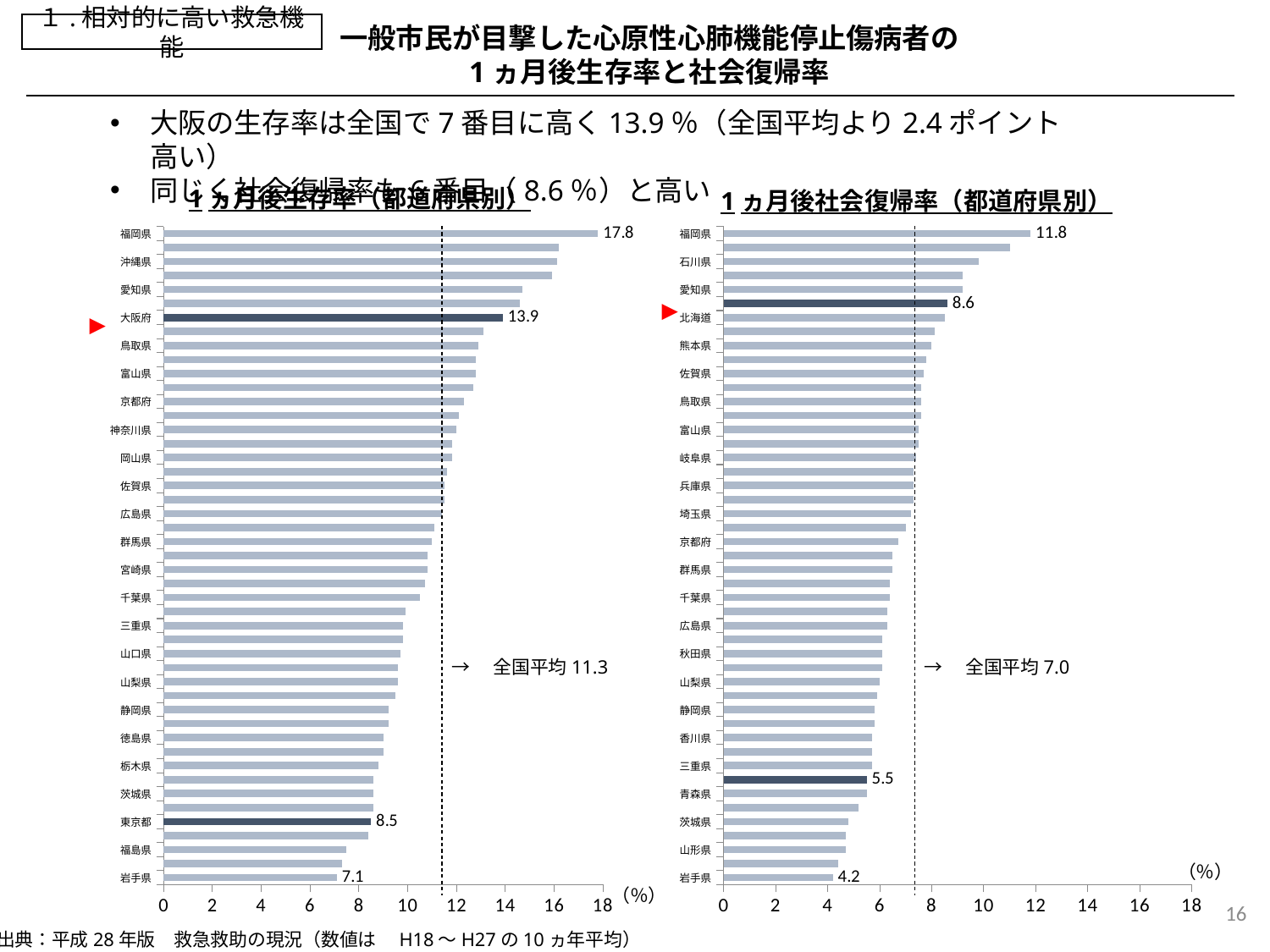
In the right chart (1ヵ月後社会復帰率), what is the value for 福岡県? 11.8 In the left chart (1ヵ月後生存率), which prefecture has the highest value? 福岡県 In the right chart (1ヵ月後社会復帰率), what national average (全国平均) is marked by the dashed line? 7.0 In the left chart (1ヵ月後生存率), what is the difference between the values for 福岡県 and 大阪府? 3.9 In the left chart (1ヵ月後生存率), what is the value for 大阪府? 13.9 In the left chart (1ヵ月後生存率), which is larger, the value for 大阪府 or the value for 東京都? 大阪府 In the left chart (1ヵ月後生存率), which prefecture has the lowest value? 岩手県 In the left chart (1ヵ月後生存率), what is the value for 福岡県? 17.8 In the right chart (1ヵ月後社会復帰率), what is the value for 岩手県? 4.2 In the left chart (1ヵ月後生存率), is the value for 静岡県 greater or less than 10? less What kind of chart is the left chart titled 1ヵ月後生存率（都道府県別）? bar chart In the left chart (1ヵ月後生存率), what is the value for 岩手県? 7.1